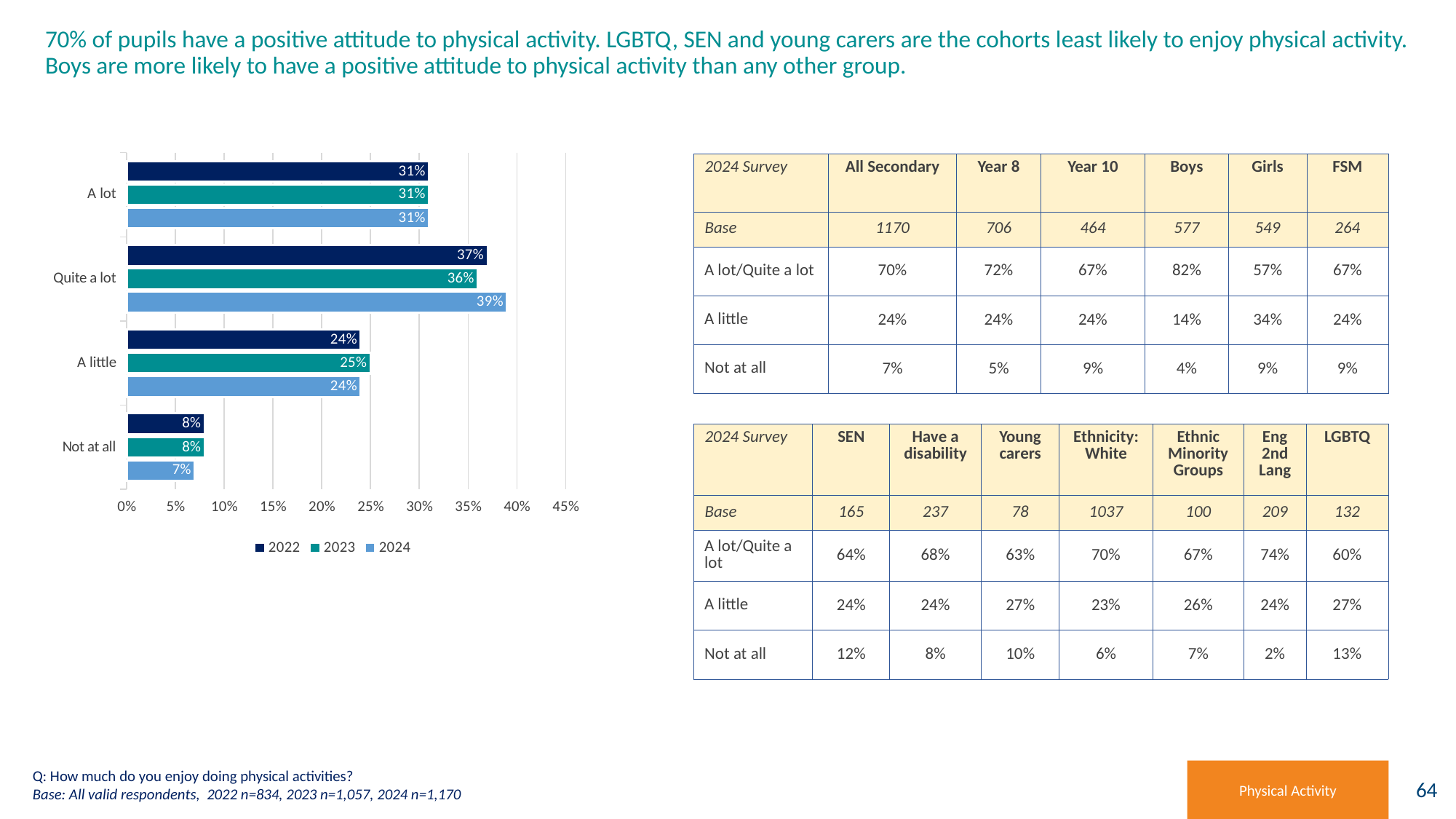
Which is larger for 'A little': the 2023 value or the 2024 value? 2023 Which category has the highest 2024 value? Quite a lot Is the 2022 value for 'Quite a lot' greater or less than 35%? greater What is the 2022 value for 'Not at all'? 8% Which series is shown in the darkest blue colour in the chart? 2022 Which category has the lowest 2022 value? Not at all How many series does the chart legend list? 3 What is the 2023 value for 'A little'? 25% What is the difference between the 2024 and 2023 values for 'Quite a lot'? 3% What kind of chart is shown on the slide? bar chart What is the 2024 value for 'Quite a lot'? 39% How many categories are shown on the chart? 4